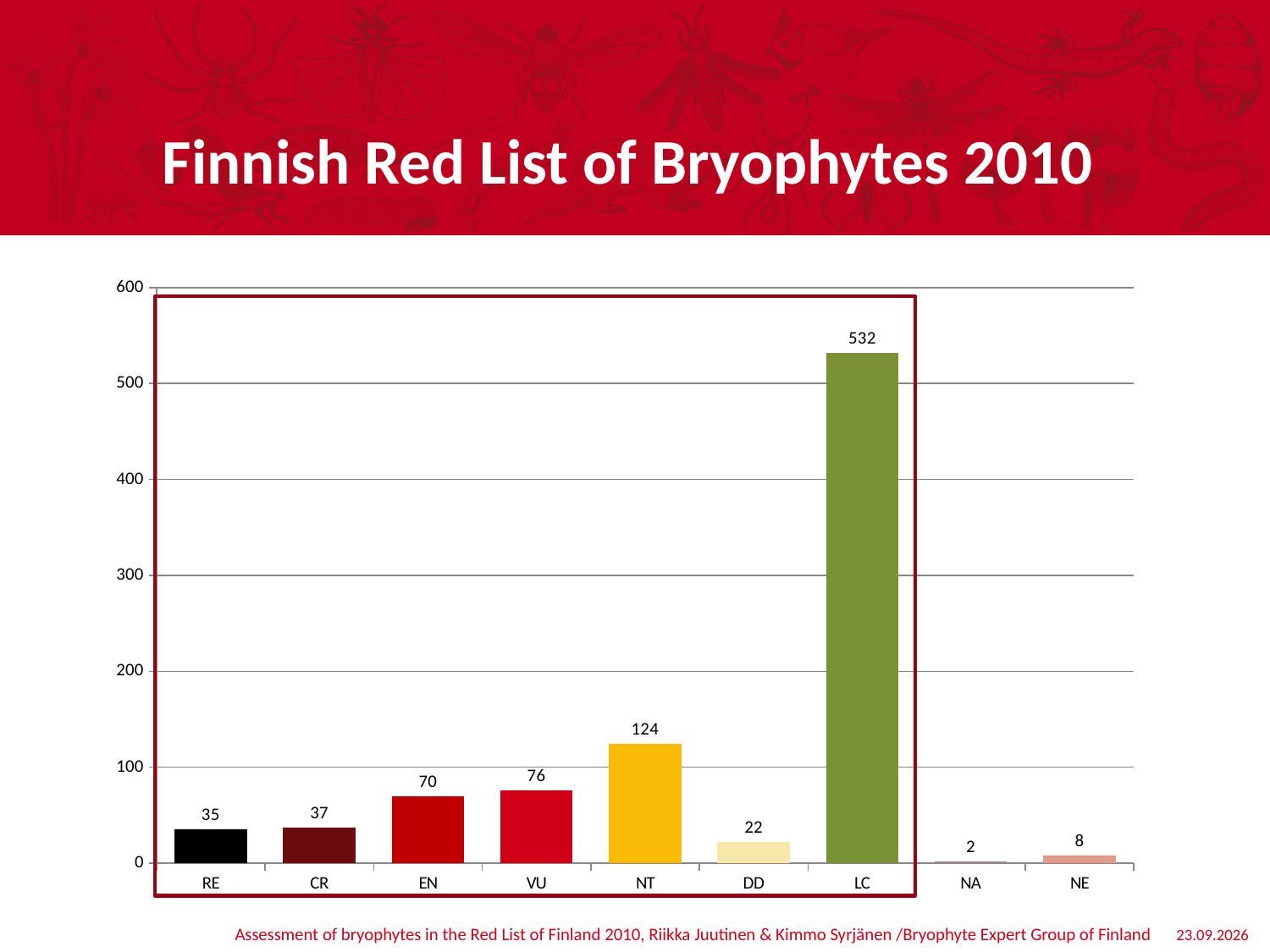
Which category has the highest value? LC Which is larger, the value for CR or the value for RE? CR What is the difference between the values for VU and EN? 6 What is the value for DD? 22 What kind of chart is shown on the slide? bar chart What is the value for LC? 532 What is the difference between the values for LC and NT? 408 What is the value for NT? 124 What colour is the bar for LC? green Is the value for NT greater or less than 100? greater How many categories are shown on the x axis? 9 Which category has the lowest value? NA